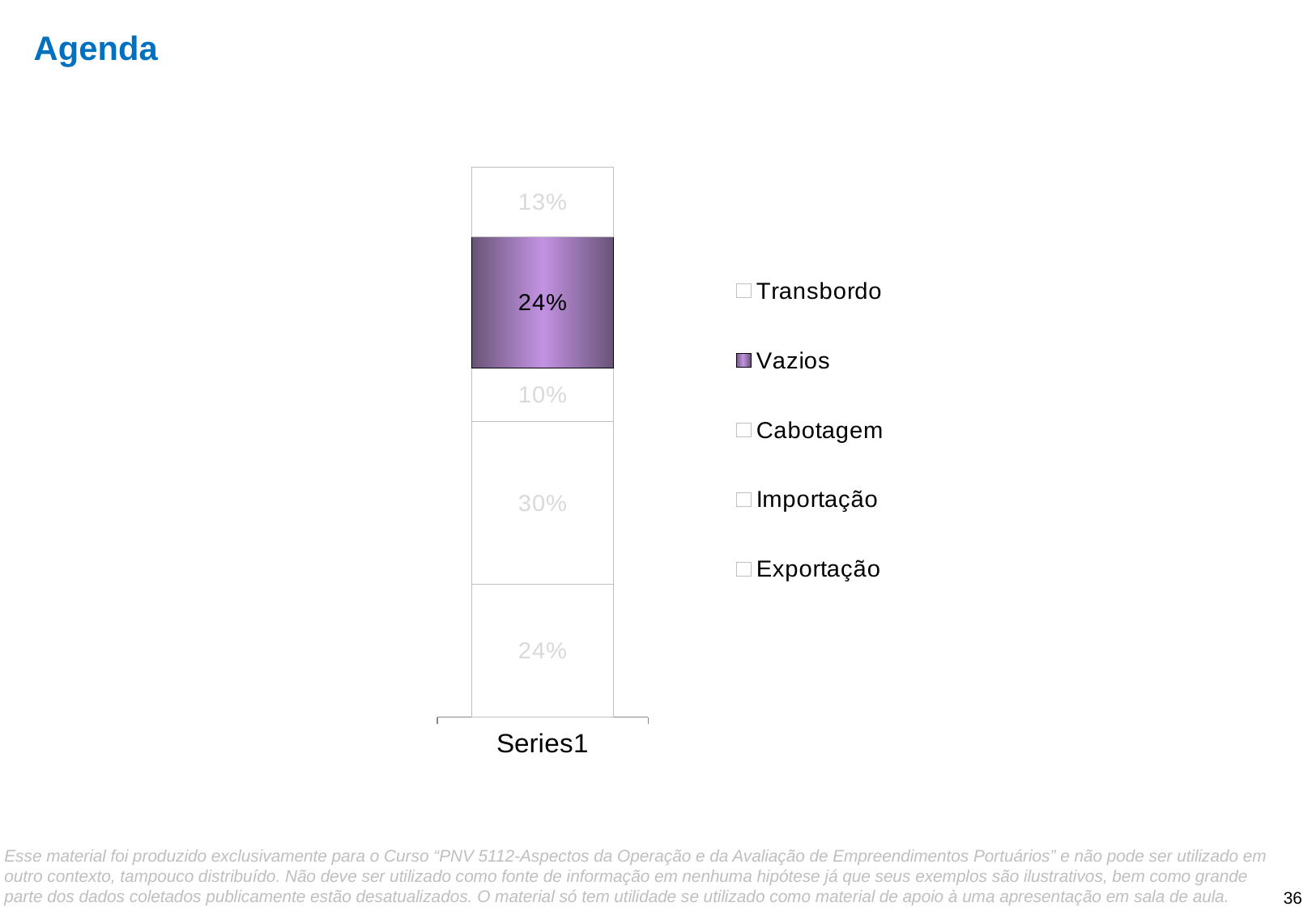
How many series does the legend list? 5 What is the difference between the values for Importação and Cabotagem? 20 percentage points What is the value for Transbordo in the stacked bar? 13% What kind of chart is shown on the slide? Stacked bar chart What is the value for Exportação in the stacked bar? 24% What is the value for Cabotagem in the stacked bar? 10% Which series is shown in purple in the stacked bar? Vazios What is the value for Vazios in the stacked bar? 24% Which series has the smallest share of the stacked bar? Cabotagem Which is larger, the value for Transbordo or the value for Cabotagem? Transbordo What is the value for Importação in the stacked bar? 30% Which series has the largest share of the stacked bar? Importação